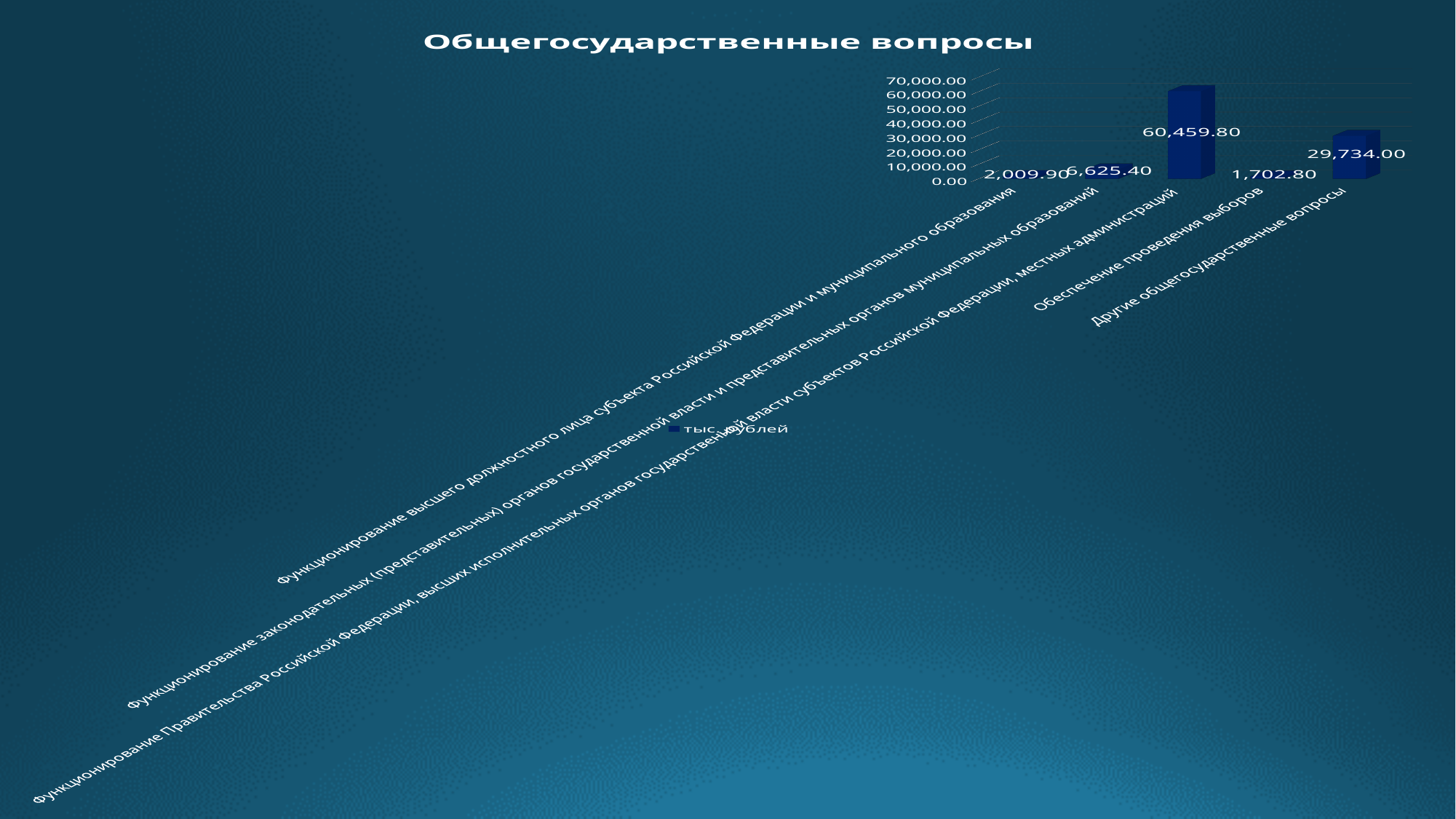
What is the difference between the values for "Другие общегосударственные вопросы" and "Обеспечение проведения выборов"? 28,031.20 How many series does the legend list? 1 What is the value for "Другие общегосударственные вопросы"? 29,734.00 What kind of chart is shown on the slide? Bar chart How many categories are shown in the chart? 5 Which is larger: the value for "Функционирование законодательных (представительных) органов государственной власти и представительных органов муниципальных образований" or for "Другие общегосударственные вопросы"? Другие общегосударственные вопросы Which category has the highest value? Функционирование Правительства Российской Федерации, высших исполнительных органов государственной власти субъектов Российской Федерации, местных администраций What is the value for "Функционирование высшего должностного лица субъекта Российской Федерации и муниципального образования"? 2,009.90 What is the value for "Обеспечение проведения выборов"? 1,702.80 What is the title of the chart? Общегосударственные вопросы What is the value for "Функционирование законодательных (представительных) органов государственной власти и представительных органов муниципальных образований"? 6,625.40 Which category has the lowest value? Обеспечение проведения выборов